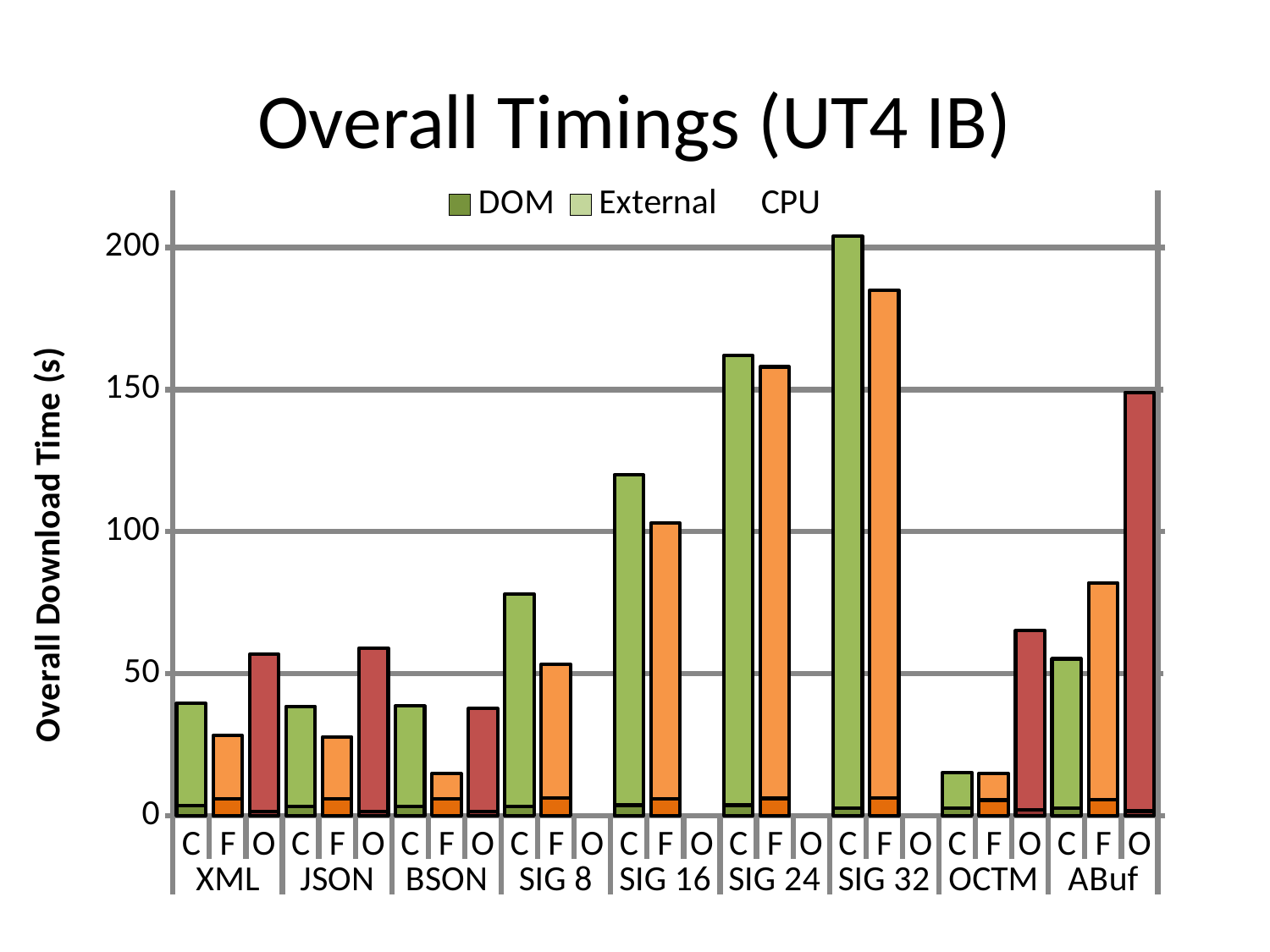
Which is larger, the bar for ABuf O or the bar for ABuf F? ABuf O Is the value for OCTM C greater or less than 50? less Is the value for SIG 8 C greater or less than 100? less How many format categories are shown along the x axis? 9 Is the value for SIG 16 C greater or less than 100? greater What kind of chart is shown on the slide? Stacked bar chart Which is larger, the bar for SIG 32 C or the bar for SIG 24 C? SIG 32 C How many series does the legend list? 3 What are the three entries in the legend? DOM, External, CPU Which bar is the tallest in the chart? SIG 32 C What is the title of the y axis? Overall Download Time (s)